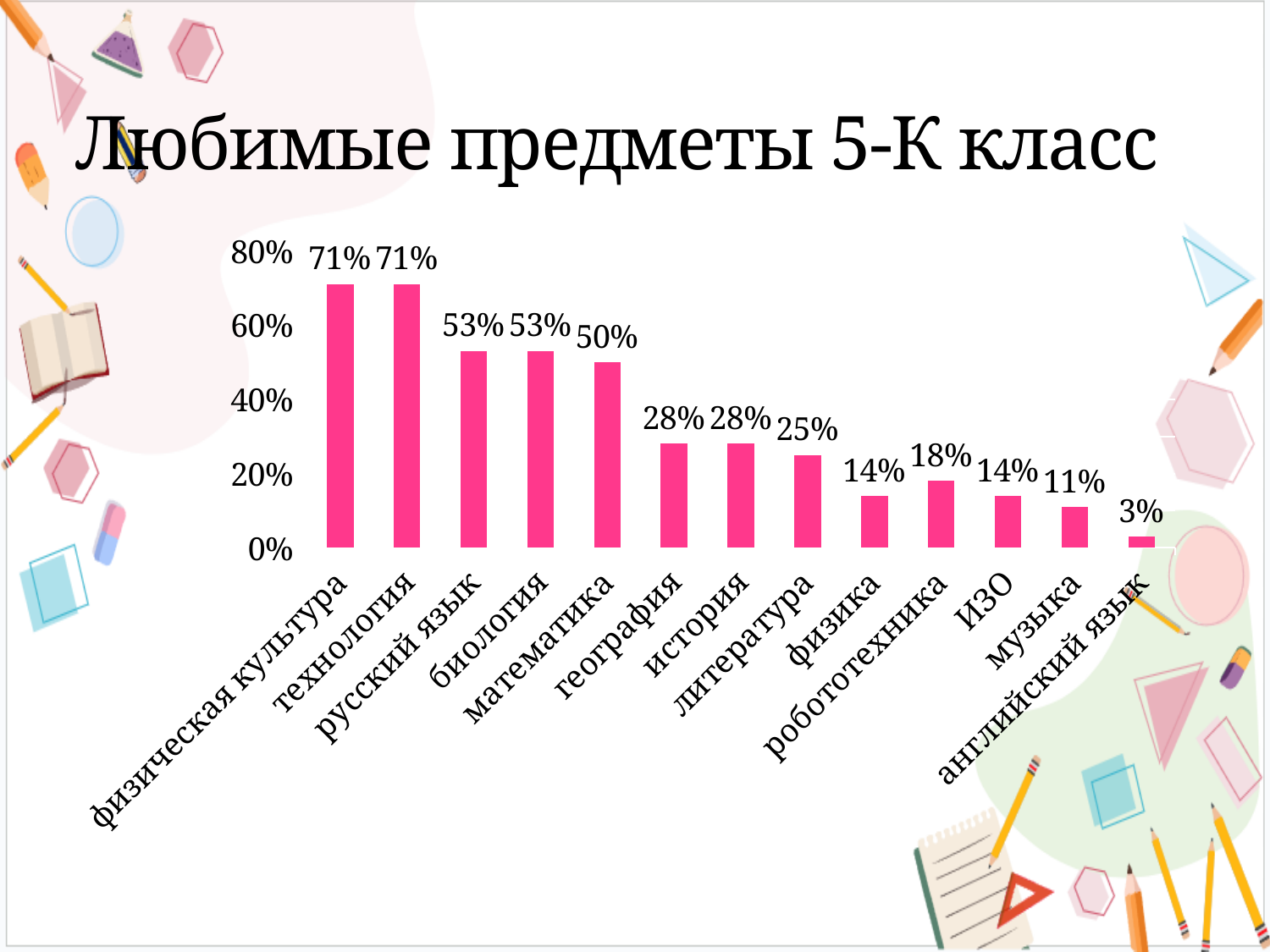
Which is larger, the value for биология or the value for история? биология What is the value for робототехника? 18% What is the difference between the values for русский язык and география? 25% What is the value for музыка? 11% Which subject has the lowest value? английский язык What is the title of the slide? Любимые предметы 5-К класс What kind of chart is shown on the slide? bar chart What is the value for математика? 50% What is the value for литература? 25% How many subjects are shown on the chart? 13 What is the difference between the values for робототехника and ИЗО? 4% Is the value for физика greater or less than 20%? less